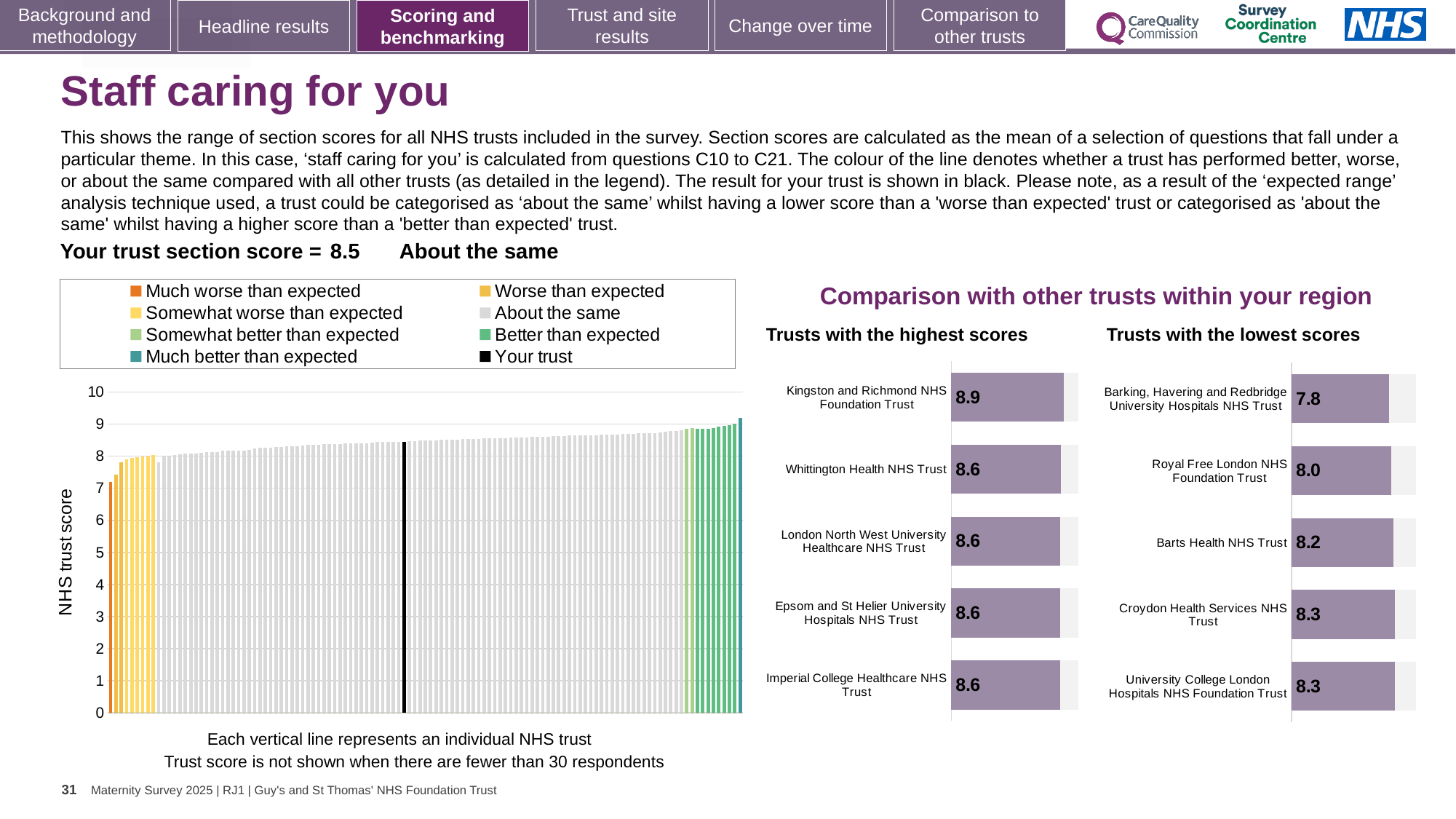
How many entries does the legend above the large chart on the left list? 8 On the 'Trusts with the highest scores' chart, how many trusts are shown? 5 On the 'Trusts with the lowest scores' chart, which has the larger score: Royal Free London NHS Foundation Trust or Barts Health NHS Trust? Barts Health NHS Trust On the 'Trusts with the highest scores' chart, what is the score for Kingston and Richmond NHS Foundation Trust? 8.9 What kind of chart is the large chart on the left showing NHS trust scores? Bar chart On the 'Trusts with the highest scores' chart, which trust has the highest score? Kingston and Richmond NHS Foundation Trust On the large chart on the left, do the trust scores rise or fall from left to right? Rise On the 'Trusts with the lowest scores' chart, what is the difference between the scores of Barts Health NHS Trust and Barking, Havering and Redbridge University Hospitals NHS Trust? 0.4 On the 'Trusts with the lowest scores' chart, which trust has the lowest score? Barking, Havering and Redbridge University Hospitals NHS Trust On the 'Trusts with the highest scores' chart, what is the difference between the scores of Kingston and Richmond NHS Foundation Trust and Whittington Health NHS Trust? 0.3 On the 'Trusts with the lowest scores' chart, what is the score for Barking, Havering and Redbridge University Hospitals NHS Trust? 7.8 On the 'Trusts with the lowest scores' chart, what is the score for Croydon Health Services NHS Trust? 8.3